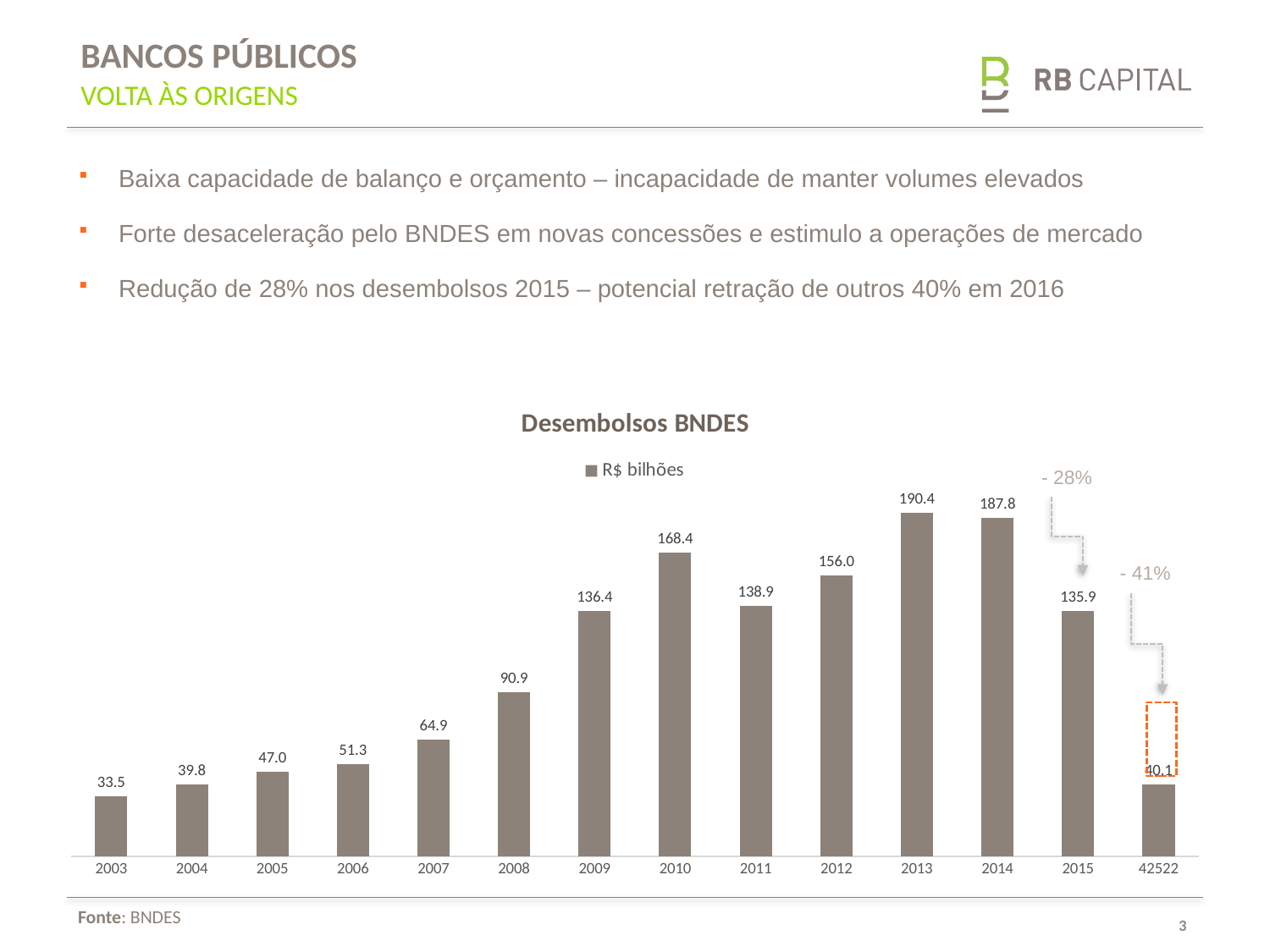
What type of chart is shown on the slide? bar chart Which year has the highest value in the Desembolsos BNDES chart? 2013 How many series does the chart legend list? 1 What is the value for 2003 in the Desembolsos BNDES chart? 33.5 Which category has the lowest value in the Desembolsos BNDES chart? 2003 Which is larger, the value for 2011 or the value for 2012? 2012 What is the difference between the values for 2014 and 2015? 51.9 Do the values rise or fall from 2003 to 2010? rise What is the value for 2008 in the Desembolsos BNDES chart? 90.9 What is the value for 2015 in the Desembolsos BNDES chart? 135.9 What is the title of the chart? Desembolsos BNDES How many bars are plotted in the Desembolsos BNDES chart? 14